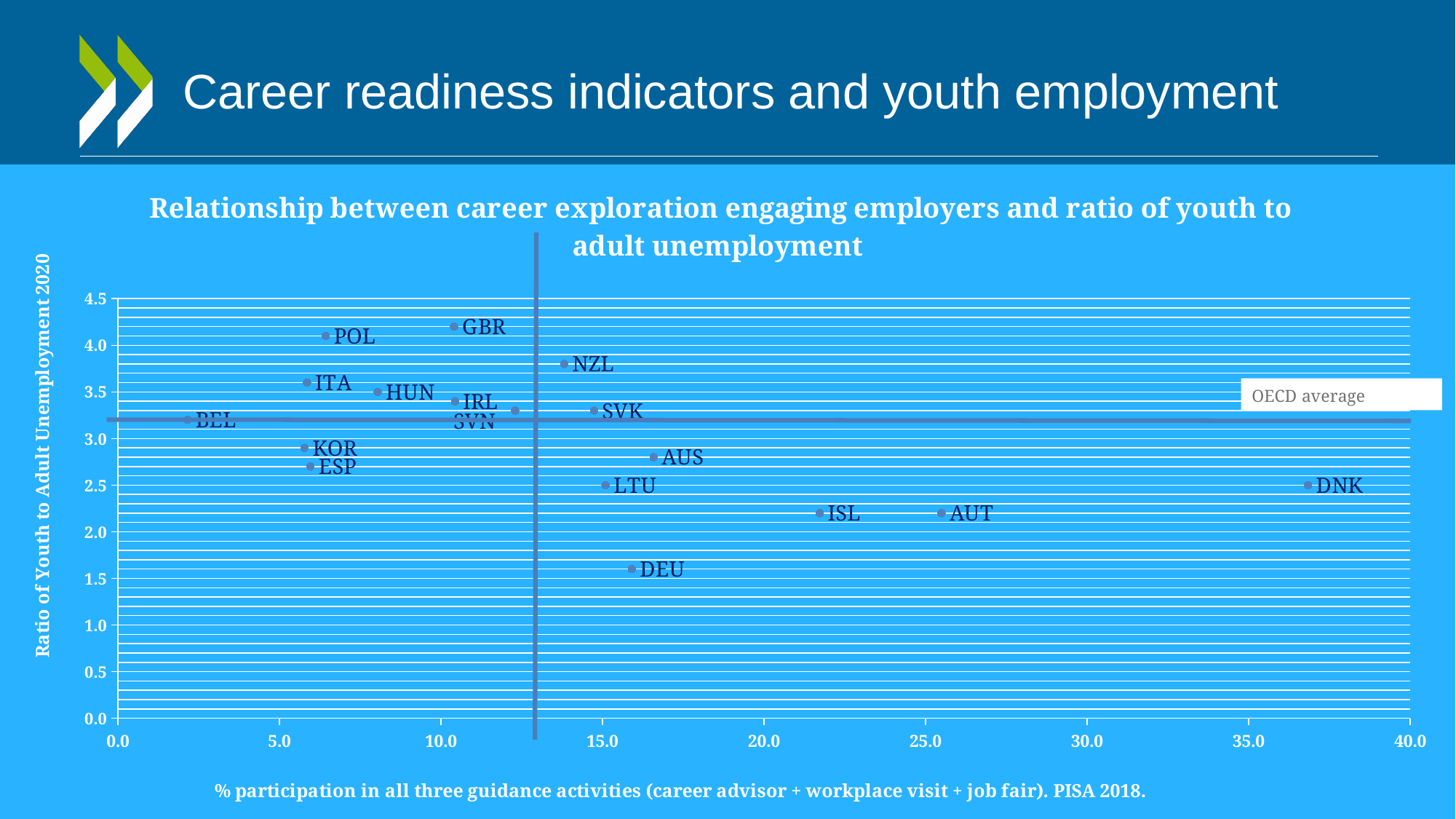
Is the ratio of youth to adult unemployment for NZL greater or less than 3.5? greater Which country has the highest ratio of youth to adult unemployment? GBR What kind of chart is shown on the slide? scatter chart Is the ratio of youth to adult unemployment for DEU greater or less than 2.0? less Which country has the lowest % participation in all three guidance activities? BEL Which country has the lowest ratio of youth to adult unemployment? DEU Which country has the highest % participation in all three guidance activities? DNK Which has a higher ratio of youth to adult unemployment, POL or ESP? POL Is the % participation value for DNK greater or less than 35.0? greater What does the horizontal line across the chart represent, according to its label? OECD average How many countries are plotted on the chart? 17